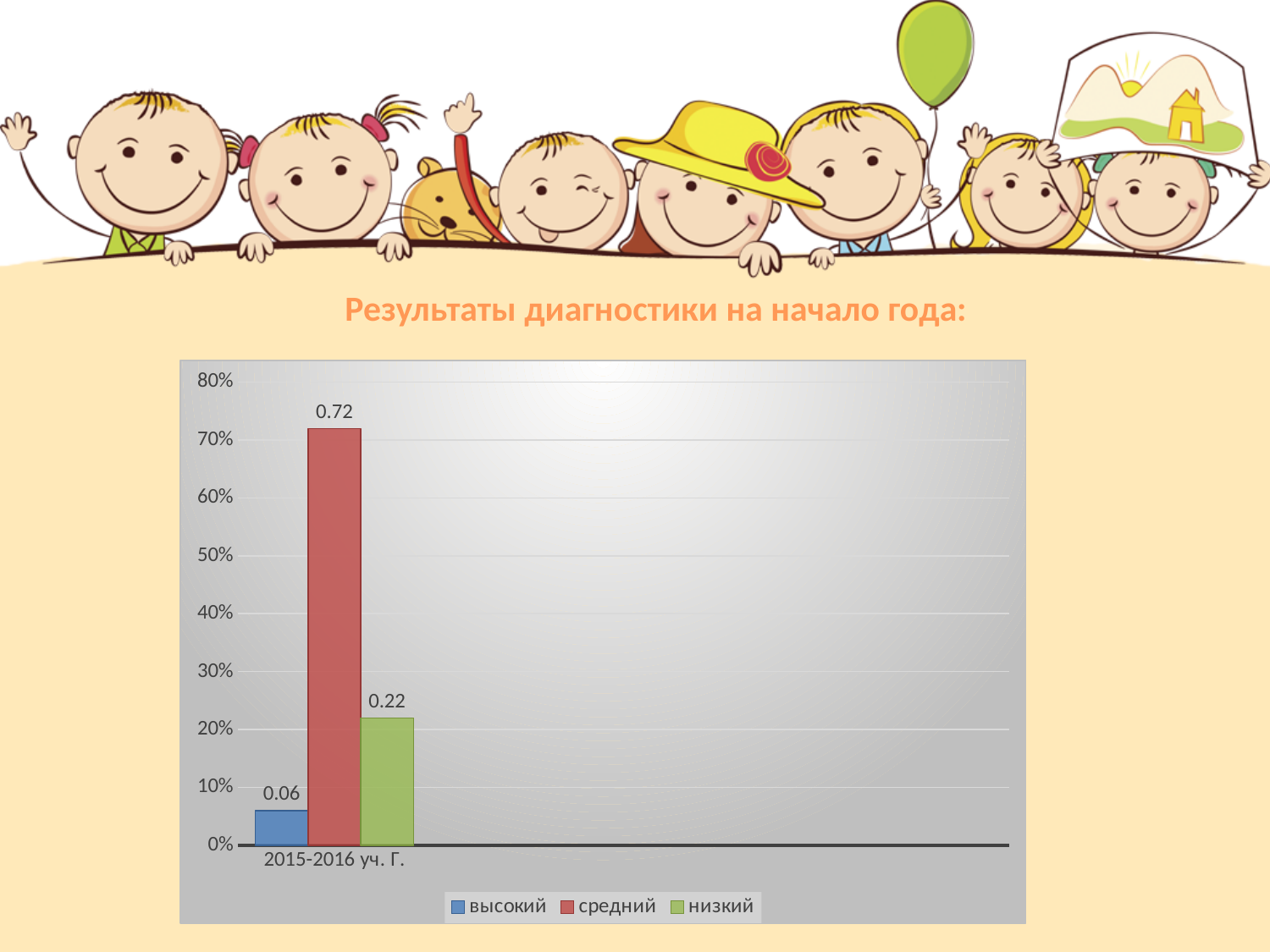
Which series has the lowest value? высокий What is the value for the 'низкий' series in 2015-2016 уч. Г.? 0.22 What is the value for the 'высокий' series in 2015-2016 уч. Г.? 0.06 How many series does the legend list? 3 What is the difference between the 'средний' and 'низкий' values? 0.5 What kind of chart is shown on the slide? bar chart What colour is the bar for the 'средний' series? red Is the value for 'средний' greater or less than 50%? greater Which is larger, the value for 'низкий' or the value for 'высокий'? низкий Which series has the highest value? средний How many categories are shown on the x axis? 1 What is the value for the 'средний' series in 2015-2016 уч. Г.? 0.72